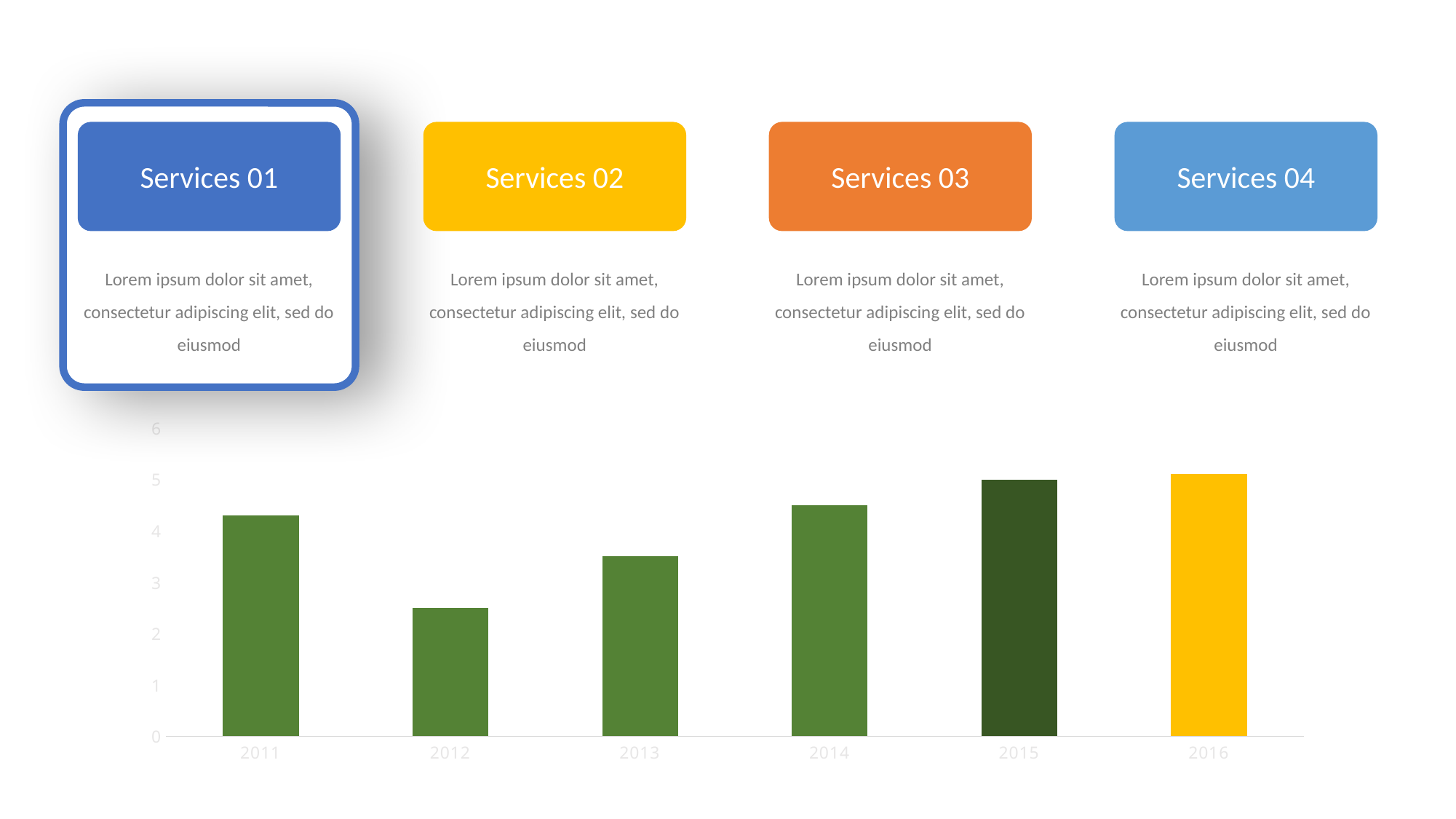
Is the value for 2012 greater or less than 3? less Is the value for 2014 greater or less than 4? greater What colour is the bar for 2016? yellow Is the value for 2011 greater or less than 4? greater Which year has the lowest bar in the chart? 2012 Which is larger, the value for 2013 or the value for 2014? 2014 How many years are shown on the x axis of the chart? 6 What kind of chart is shown on the slide? bar chart From 2012 to 2016, do the bar values rise or fall? rise Which is larger, the value for 2011 or the value for 2012? 2011